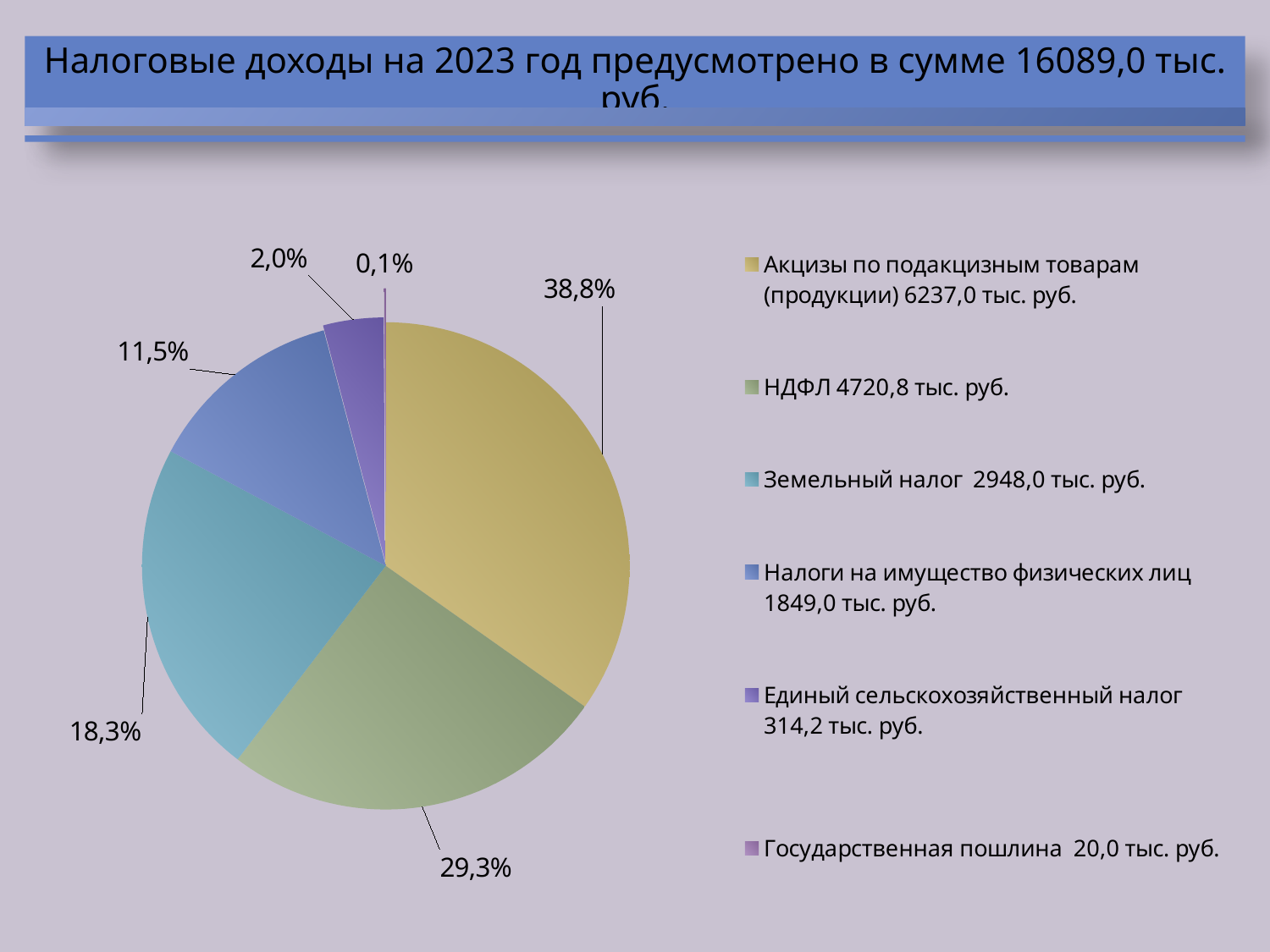
What share of the pie does "Налоги на имущество физических лиц" take? 11,5% What share of the pie does "Акцизы по подакцизным товарам (продукции)" take? 38,8% What share of the pie does "Государственная пошлина" take? 0,1% What is the difference in percentage points between the "Акцизы по подакцизным товарам (продукции)" slice and the "НДФЛ" slice? 9,5 What kind of chart is shown on the slide? pie chart Which category has the smallest slice of the pie? Государственная пошлина How many slices does the pie chart have? 6 How many entries does the legend list? 6 Which is larger, the "Земельный налог" slice or the "Налоги на имущество физических лиц" slice? Земельный налог Which category has the largest slice of the pie? Акцизы по подакцизным товарам (продукции)